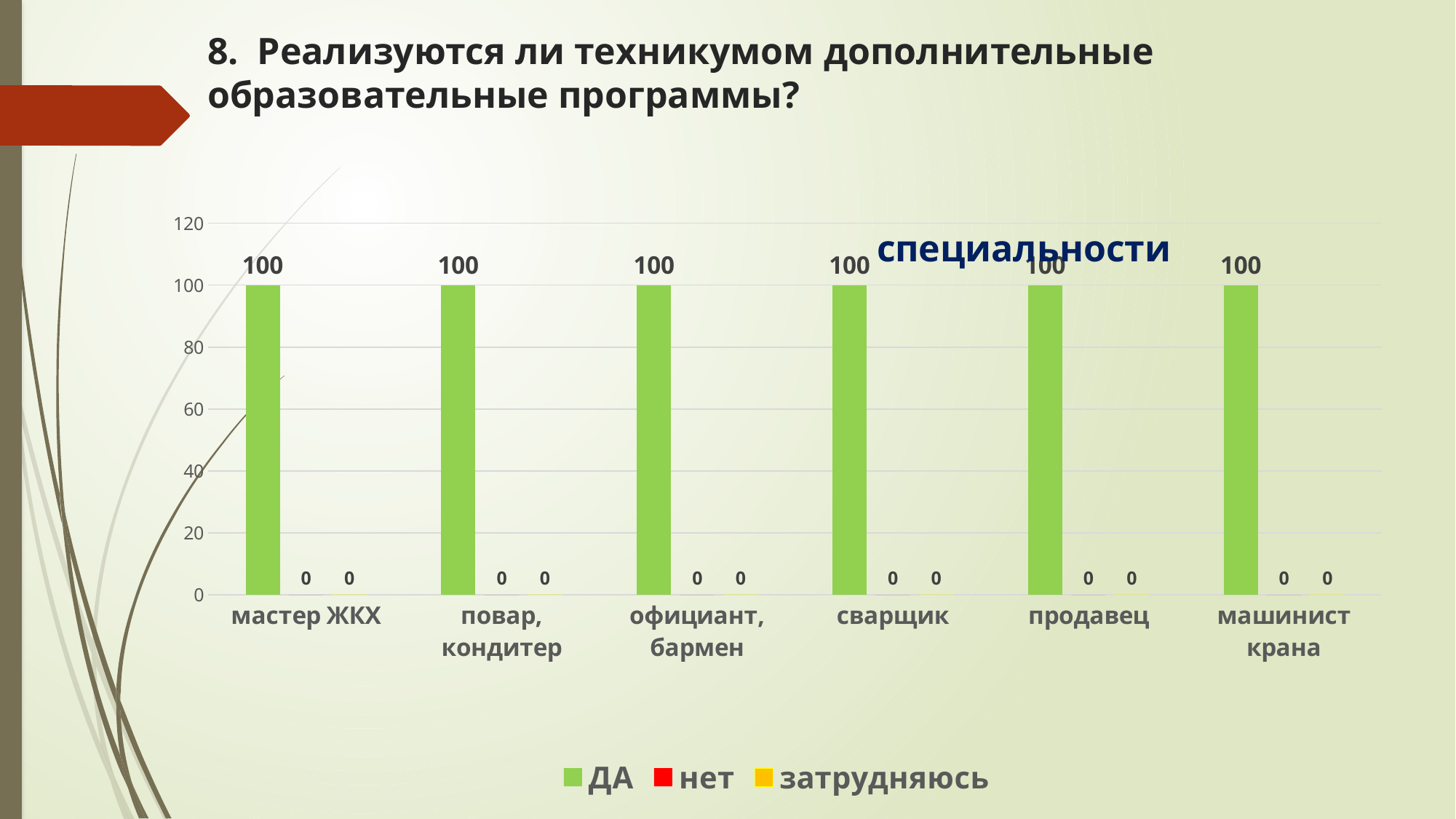
What is the value of the затрудняюсь series for продавец? 0 What is the value of the нет series for мастер ЖКХ? 0 How many series does the legend list? 3 What colour are the ДА bars? green What is the value of the ДА series for машинист крана? 100 What kind of chart is shown on the slide? bar chart What is the label printed in blue above the chart? специальности Is the ДА value for продавец greater or less than 80? greater Which is larger for повар, кондитер: the ДА value or the нет value? ДА How many categories are shown on the x axis? 6 What is the value of the ДА series for сварщик? 100 What is the difference between the ДА value and the затрудняюсь value for официант, бармен? 100